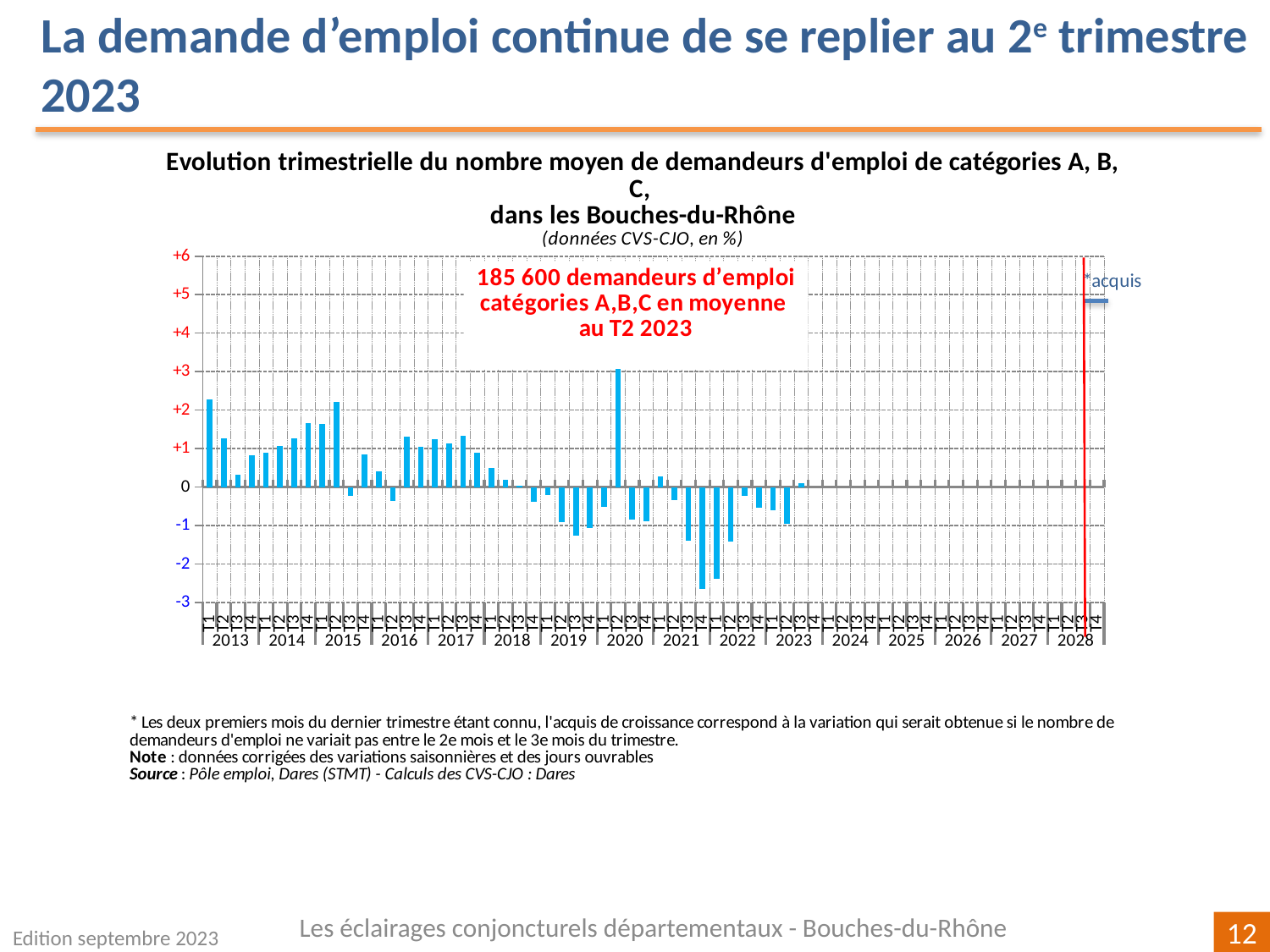
Which is larger, the value for T4 2021 or the value for T2 2019? T2 2019 According to the text box on the chart, how many job seekers in categories A, B, C were there on average in T2 2023? 185 600 Which quarter has the highest value in the chart? T2 2020 What kind of chart is shown on the slide? bar chart Is the value for T3 2023 positive or negative? positive Is the value for T2 2020 greater or less than +2? greater Which is larger, the value for T2 2020 or the value for T1 2013? T2 2020 Is the value for T4 2021 greater or less than -2? less What is the highest value shown on the vertical axis? +6 What is the first year and the last year shown on the horizontal axis? 2013 and 2028